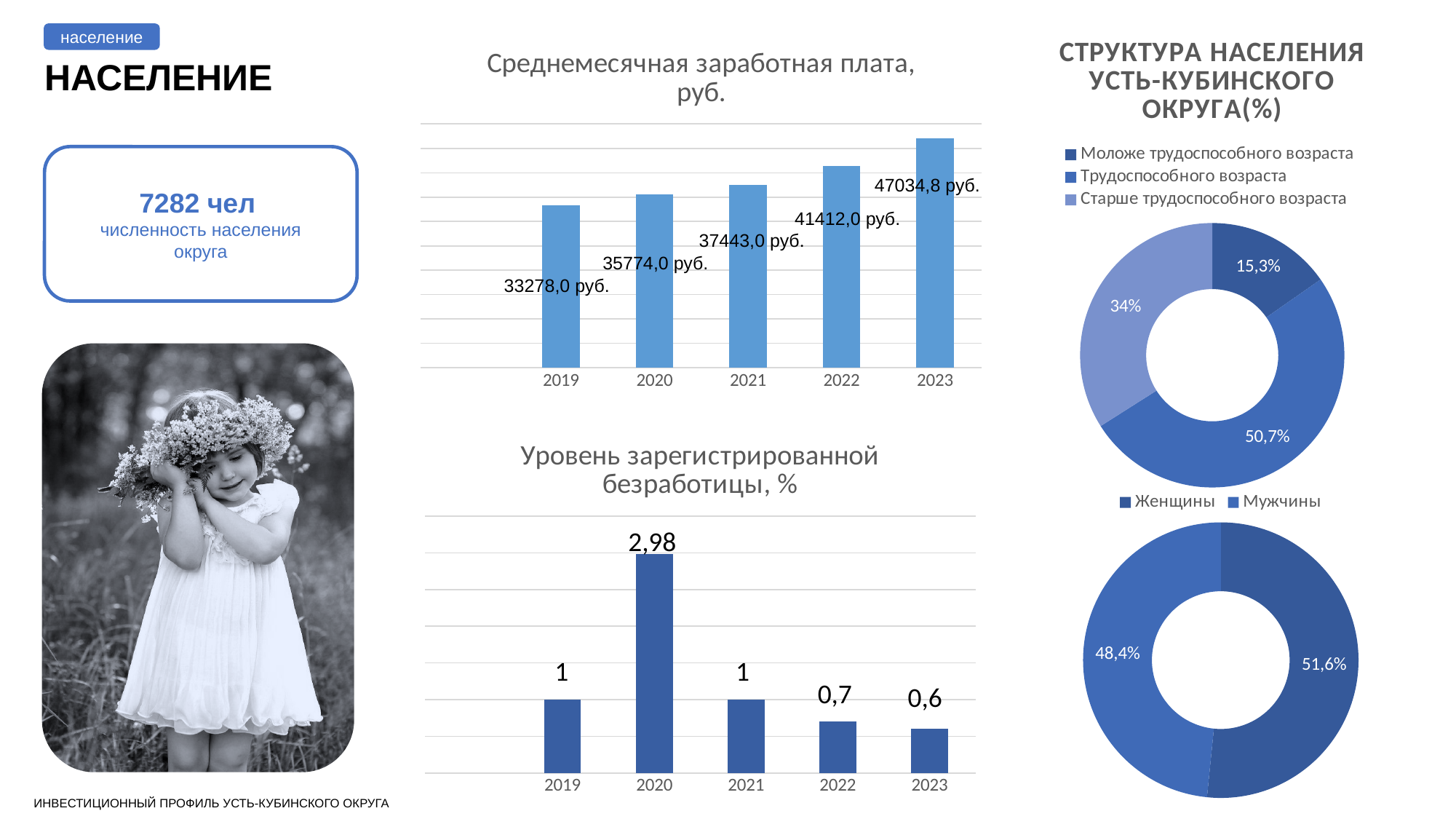
On the chart 'Уровень зарегистрированной безработицы, %', which year has the highest value? 2020 On the upper donut chart 'Структура населения Усть-Кубинского округа(%)', how many categories does the legend list? 3 On the chart 'Среднемесячная заработная плата, руб.', do the values rise or fall from 2019 to 2023? rise On the chart 'Среднемесячная заработная плата, руб.', what is the value for 2019? 33278,0 руб. On the upper donut chart 'Структура населения Усть-Кубинского округа(%)', what is the share for 'Трудоспособного возраста'? 50,7% On the chart 'Уровень зарегистрированной безработицы, %', what kind of chart is it? bar chart On the chart 'Уровень зарегистрированной безработицы, %', which year has the lowest value? 2023 On the chart 'Среднемесячная заработная плата, руб.', what is the difference between the 2023 and 2019 values? 13756,8 руб. On the chart 'Среднемесячная заработная плата, руб.', which year has the lowest value? 2019 On the chart 'Уровень зарегистрированной безработицы, %', what is the value for 2020? 2,98 On the chart 'Уровень зарегистрированной безработицы, %', how many years are shown on the x axis? 5 On the chart 'Среднемесячная заработная плата, руб.', what is the value for 2023? 47034,8 руб.